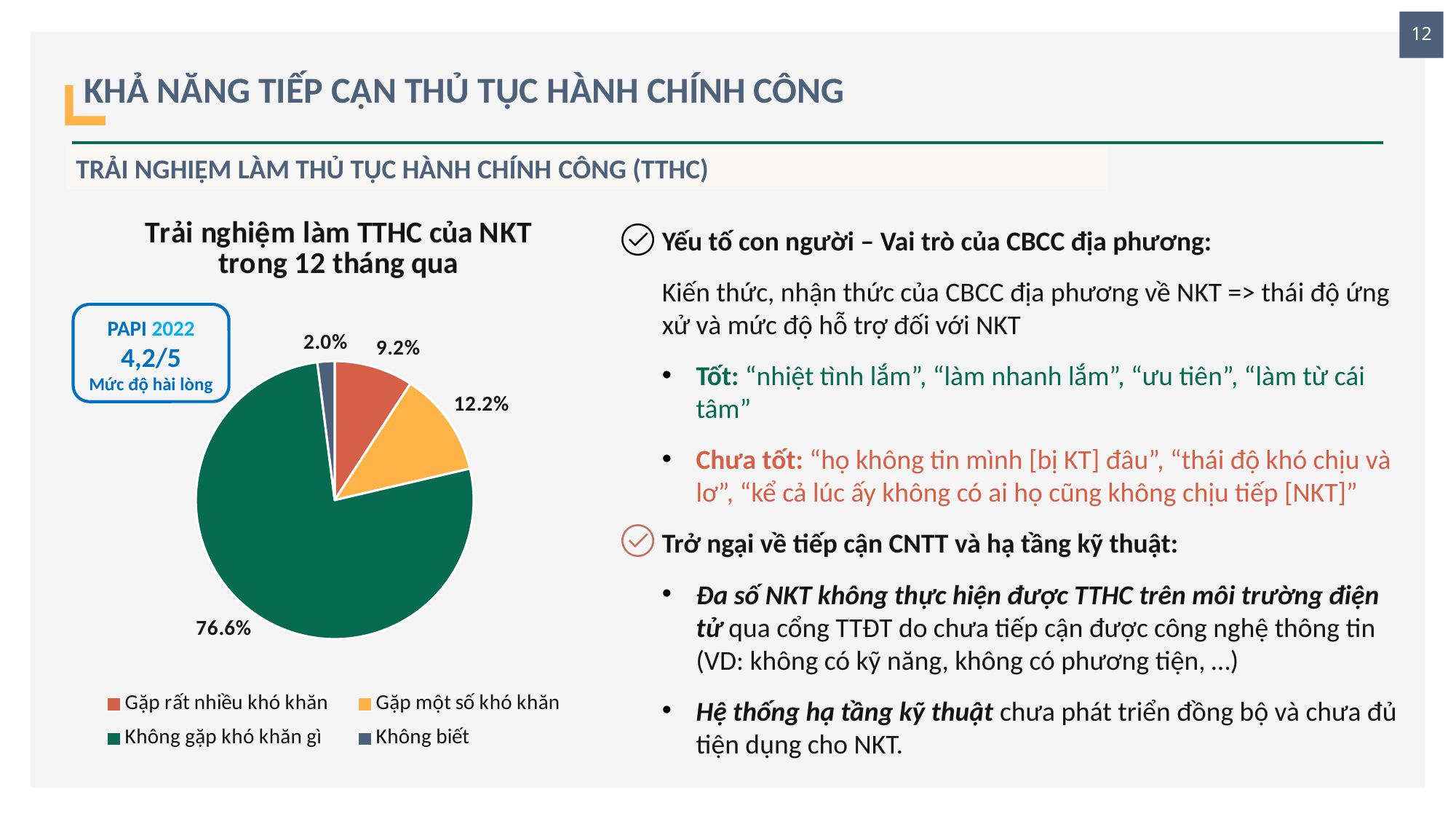
How many categories does the pie chart have? 4 What share of the pie is "Không gặp khó khăn gì"? 76.6% Which category has the smallest slice of the pie? Không biết Which category has the largest slice of the pie? Không gặp khó khăn gì Which is larger: the share of "Gặp rất nhiều khó khăn" or the share of "Gặp một số khó khăn"? Gặp một số khó khăn What kind of chart is shown on the slide? Pie chart What share of the pie is "Gặp rất nhiều khó khăn"? 9.2% What share of the pie is "Không biết"? 2.0% What is the title of the pie chart? Trải nghiệm làm TTHC của NKT trong 12 tháng qua What colour is the slice for "Không gặp khó khăn gì"? Green What is the difference between the shares of "Gặp một số khó khăn" and "Gặp rất nhiều khó khăn"? 3.0%